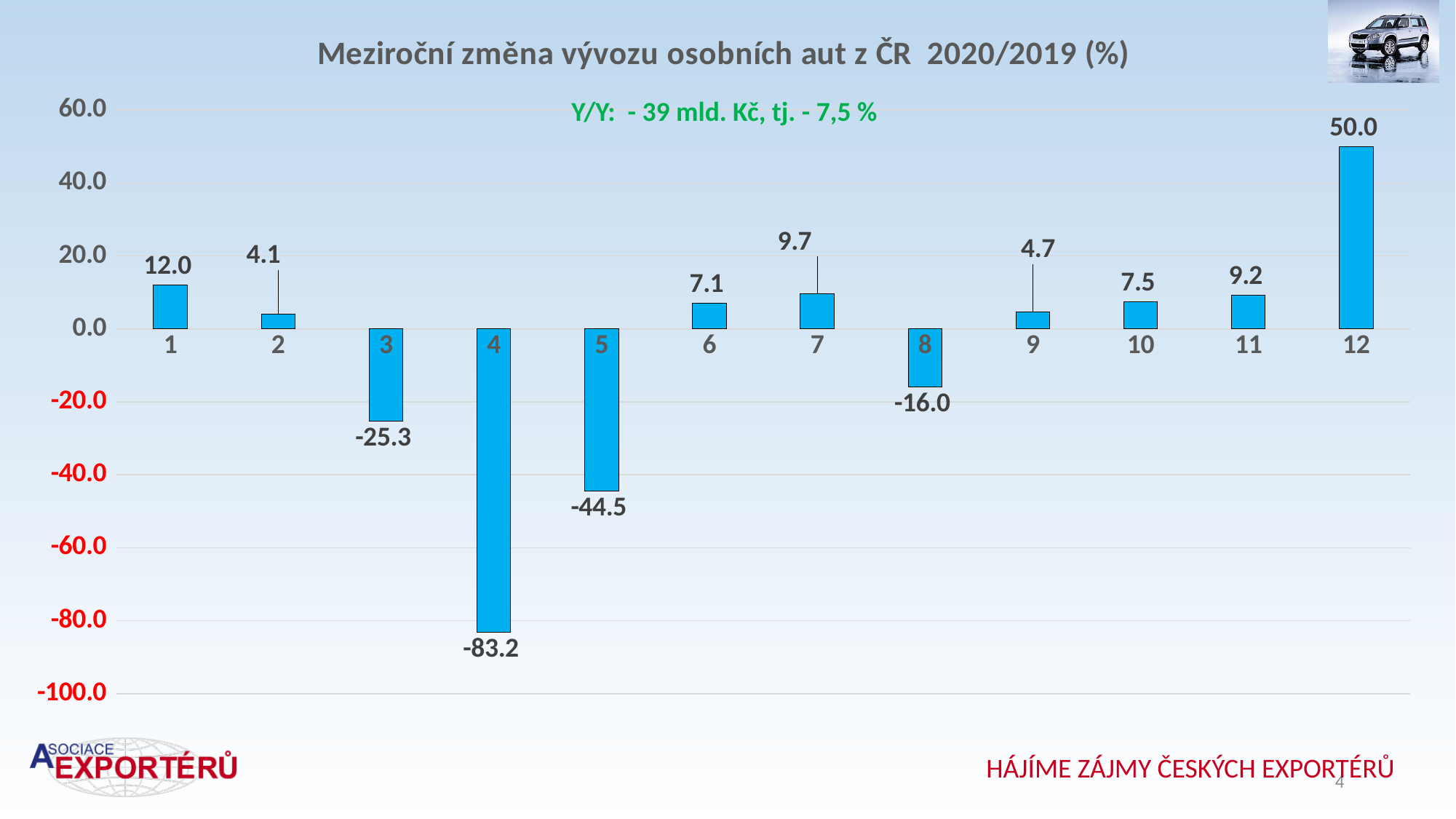
Which is larger, the value for month 7 or the value for month 11? month 7 What is the value for month 12? 50.0 What is the title of the chart? Meziroční změna vývozu osobních aut z ČR 2020/2019 (%) Which month has the highest value? 12 How many months have a negative value? 4 How many months are shown on the x axis? 12 Is the value for month 5 greater or less than -40.0? less What is the difference between the values for month 1 and month 2? 7.9 What kind of chart is this? bar chart What is the value for month 4? -83.2 Which month has the lowest value? 4 What is the value for month 8? -16.0